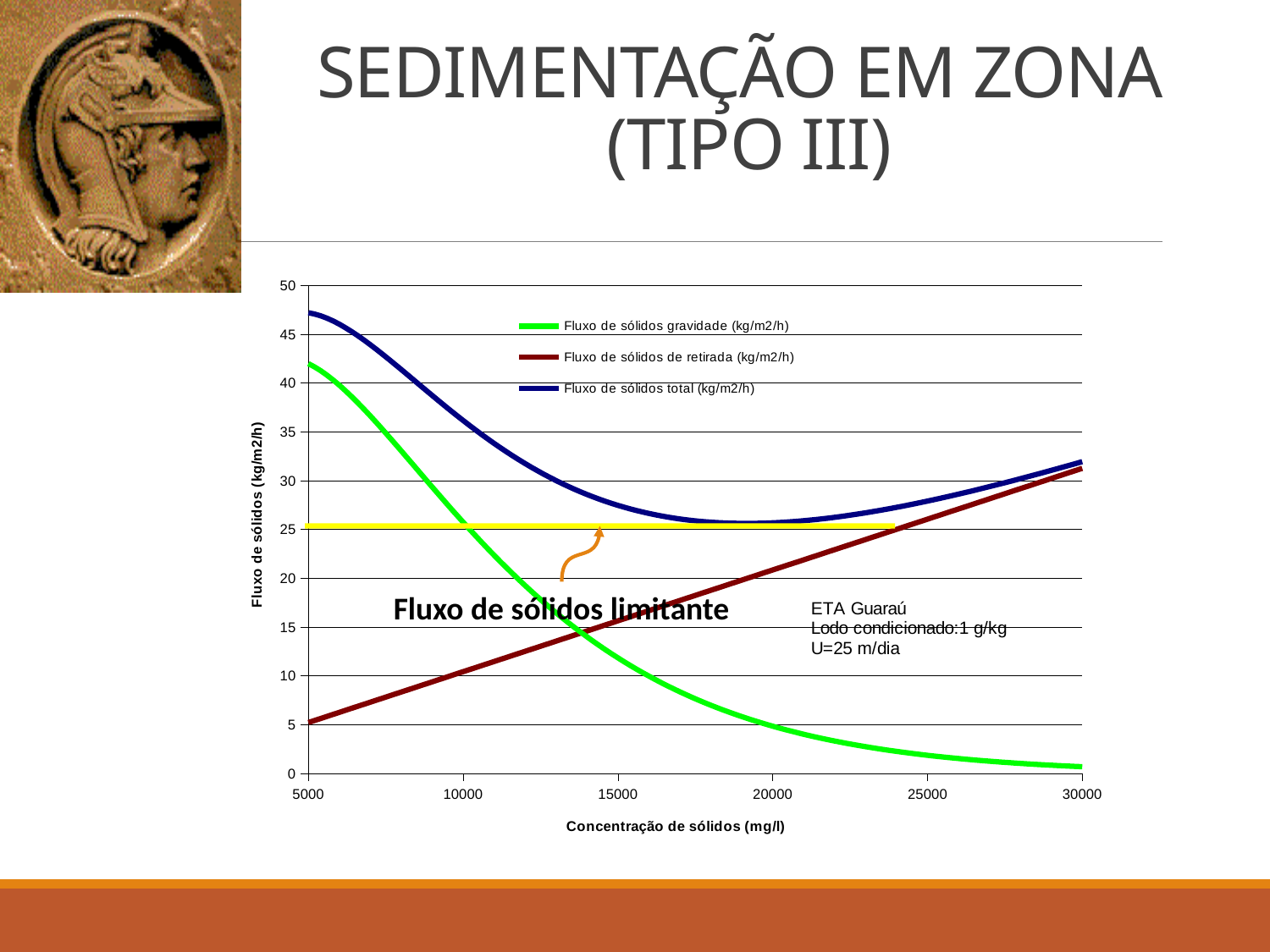
What kind of chart is shown on the slide? line chart What is the title of the x axis of the chart? Concentração de sólidos (mg/l) Is the value of Fluxo de sólidos de retirada (kg/m2/h) at a concentration of 5000 mg/l greater or less than 10? less At a concentration of 5000 mg/l, which is larger: Fluxo de sólidos gravidade or Fluxo de sólidos de retirada? Fluxo de sólidos gravidade Is the value of Fluxo de sólidos gravidade (kg/m2/h) at a concentration of 30000 mg/l greater or less than 5? less Does the Fluxo de sólidos de retirada (kg/m2/h) series rise or fall as the concentration increases along the x axis? rise How many series does the chart legend list? 3 At a concentration of 30000 mg/l, which is larger: Fluxo de sólidos gravidade or Fluxo de sólidos de retirada? Fluxo de sólidos de retirada Is the value of Fluxo de sólidos gravidade (kg/m2/h) at a concentration of 5000 mg/l greater or less than 40? greater Which colour is used for the Fluxo de sólidos total (kg/m2/h) series in the chart? blue Does the Fluxo de sólidos gravidade (kg/m2/h) series rise or fall as the concentration increases along the x axis? fall